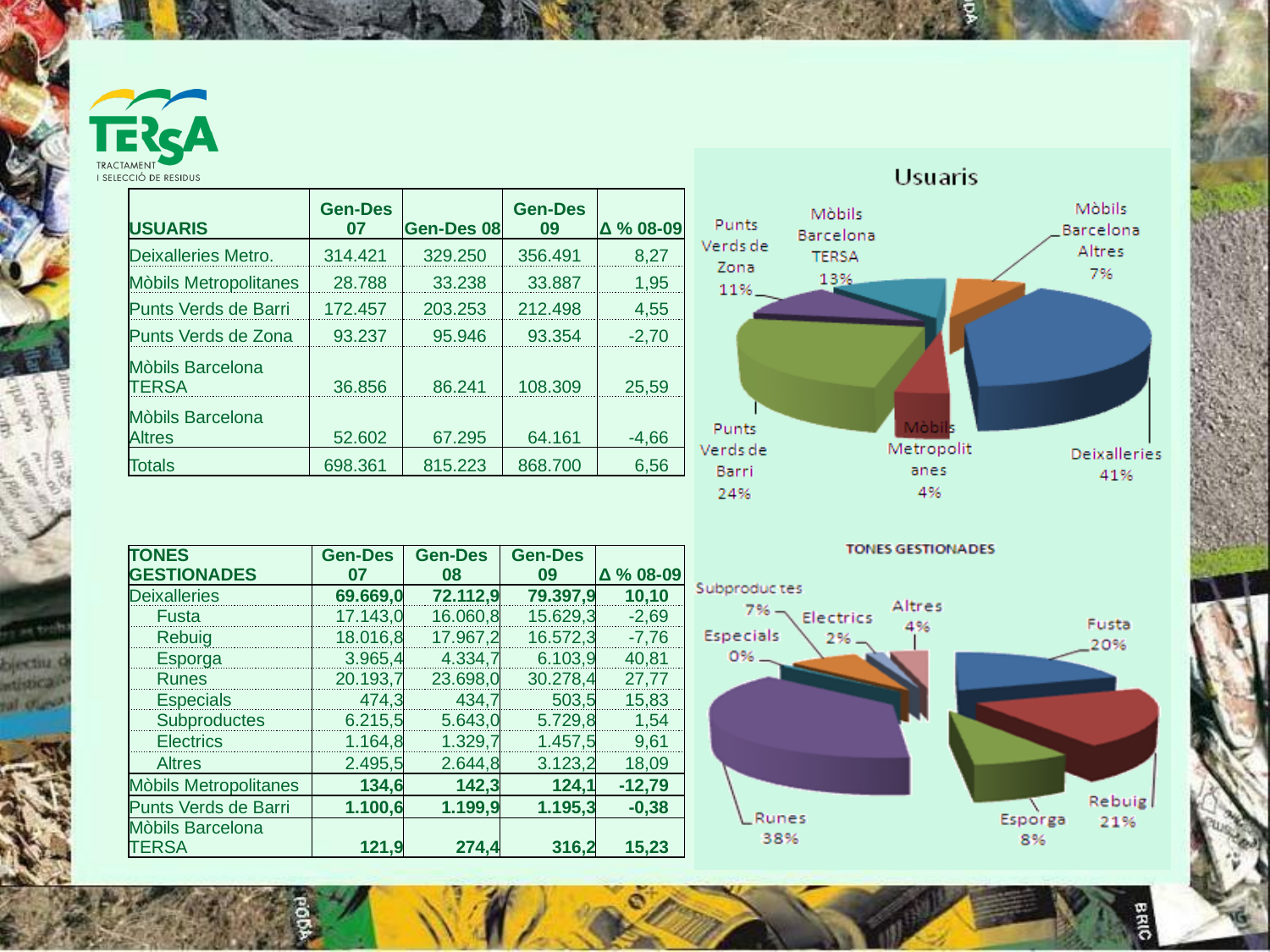
What kind of chart is the 'TONES GESTIONADES' chart? Pie chart In the 'Usuaris' chart, which category has the largest slice? Deixalleries In the 'TONES GESTIONADES' chart, what percentage is shown for Runes? 38% In the 'Usuaris' chart, which category has the smallest slice? Mòbils Metropolitanes In the 'Usuaris' chart, which is larger: Punts Verds de Zona or Mòbils Barcelona TERSA? Mòbils Barcelona TERSA In the 'Usuaris' chart, what share of the pie does Deixalleries have? 41% In the 'Usuaris' chart, what percentage is shown for Punts Verds de Barri? 24% In the 'Usuaris' chart, how many slices does the pie have? 6 In the 'TONES GESTIONADES' chart, what percentage is shown for Especials? 0% In the 'TONES GESTIONADES' chart, how many slices are labelled? 8 In the 'Usuaris' chart, what is the difference in percentage points between Mòbils Barcelona TERSA and Mòbils Barcelona Altres? 6 In the 'TONES GESTIONADES' chart, which category has the largest slice? Runes